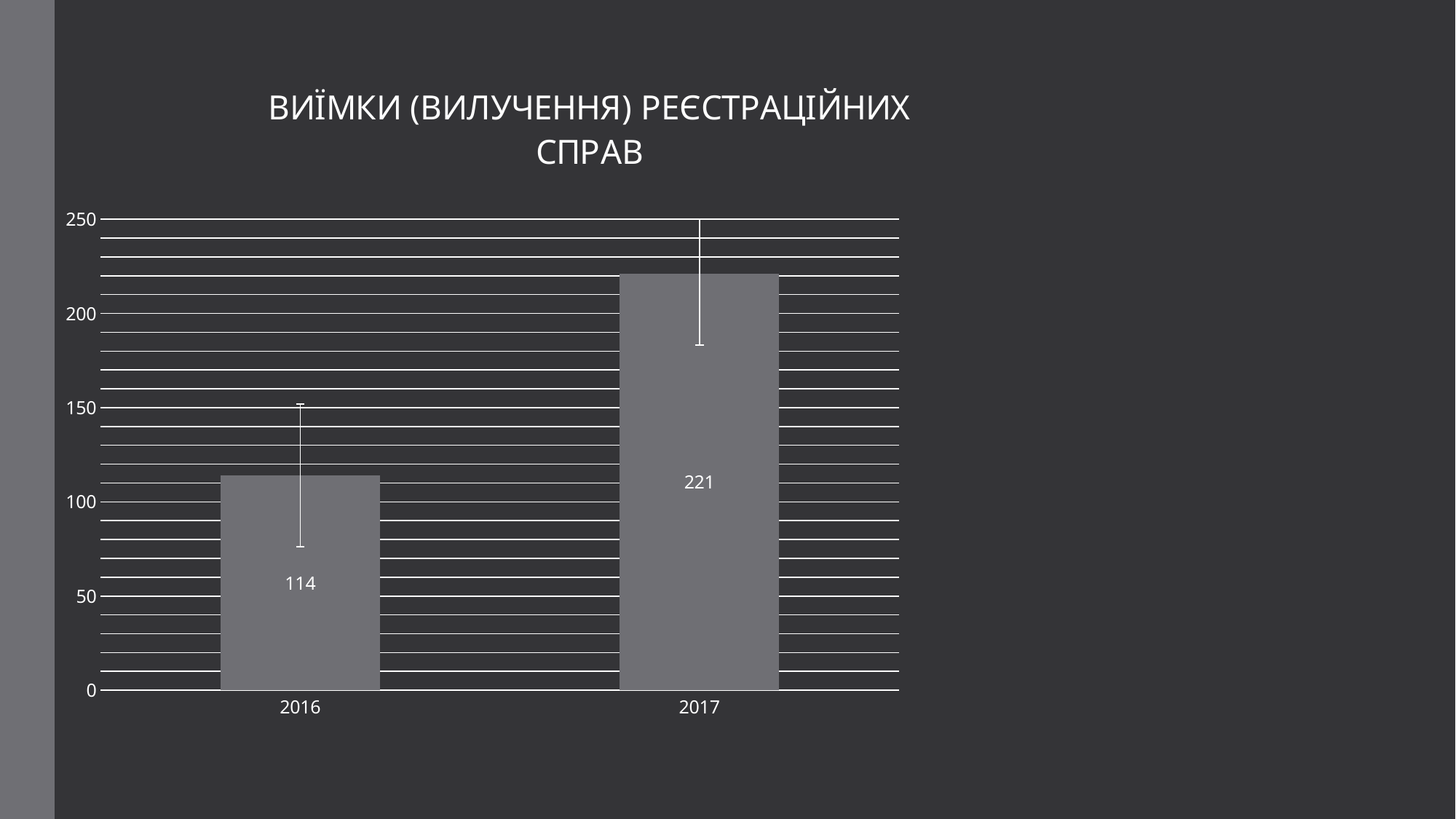
Is the value for 2017 greater or less than 200? greater What is the value for 2016? 114 Which year has the lowest value? 2016 Is the value for 2016 greater or less than 150? less What is the value for 2017? 221 Which is larger, the value for 2016 or the value for 2017? 2017 Do the values rise or fall from 2016 to 2017? rise Which year has the highest value? 2017 How many categories are shown on the x axis? 2 What kind of chart is shown on the slide? bar chart What is the difference between the values for 2017 and 2016? 107 What is the title of the chart? ВИЇМКИ (ВИЛУЧЕННЯ) РЕЄСТРАЦІЙНИХ СПРАВ